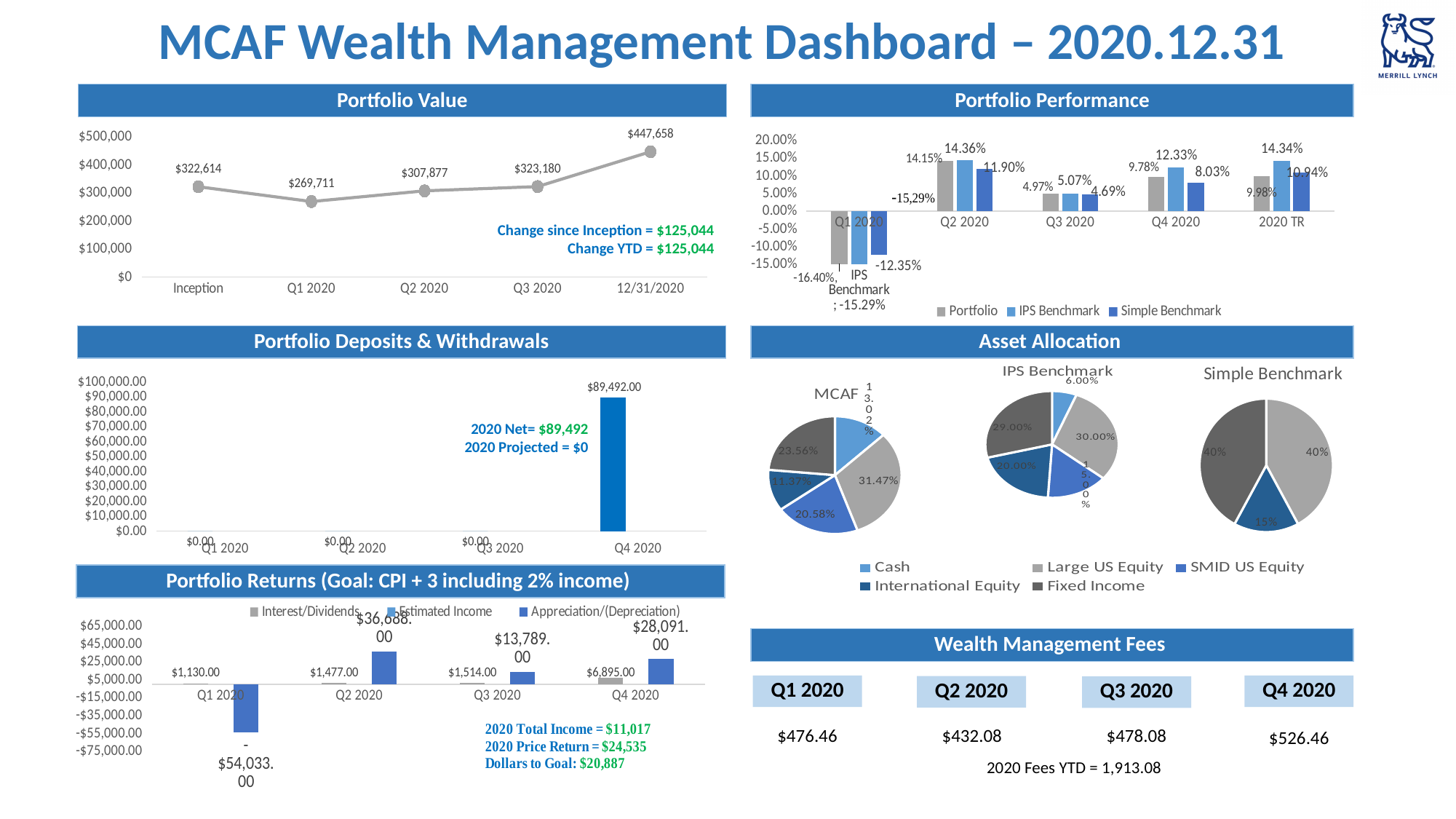
In the Portfolio Performance chart, how many series does the legend list? 3 In the Portfolio Performance chart, what is the IPS Benchmark value for Q4 2020? 12.33% In the MCAF pie of the Asset Allocation section, what share is Large US Equity? 31.47% In the Portfolio Value chart, how many data points are plotted? 5 In the Portfolio Deposits & Withdrawals chart, what is the value for Q4 2020? $89,492.00 In the Portfolio Performance chart, what is the Portfolio value for Q2 2020? 14.15% In the Portfolio Value chart, which point has the lowest value? Q1 2020 In the Portfolio Performance chart, which is larger for 2020 TR: Portfolio or Simple Benchmark? Simple Benchmark In the Portfolio Value chart, what is the portfolio value at 12/31/2020? $447,658 In the Portfolio Value chart, what is the difference between the value at 12/31/2020 and the value at Inception? $125,044 What kind of chart is the Portfolio Deposits & Withdrawals chart? Bar chart In the Portfolio Returns chart, what is the Appreciation/(Depreciation) value for Q1 2020? -$54,033.00